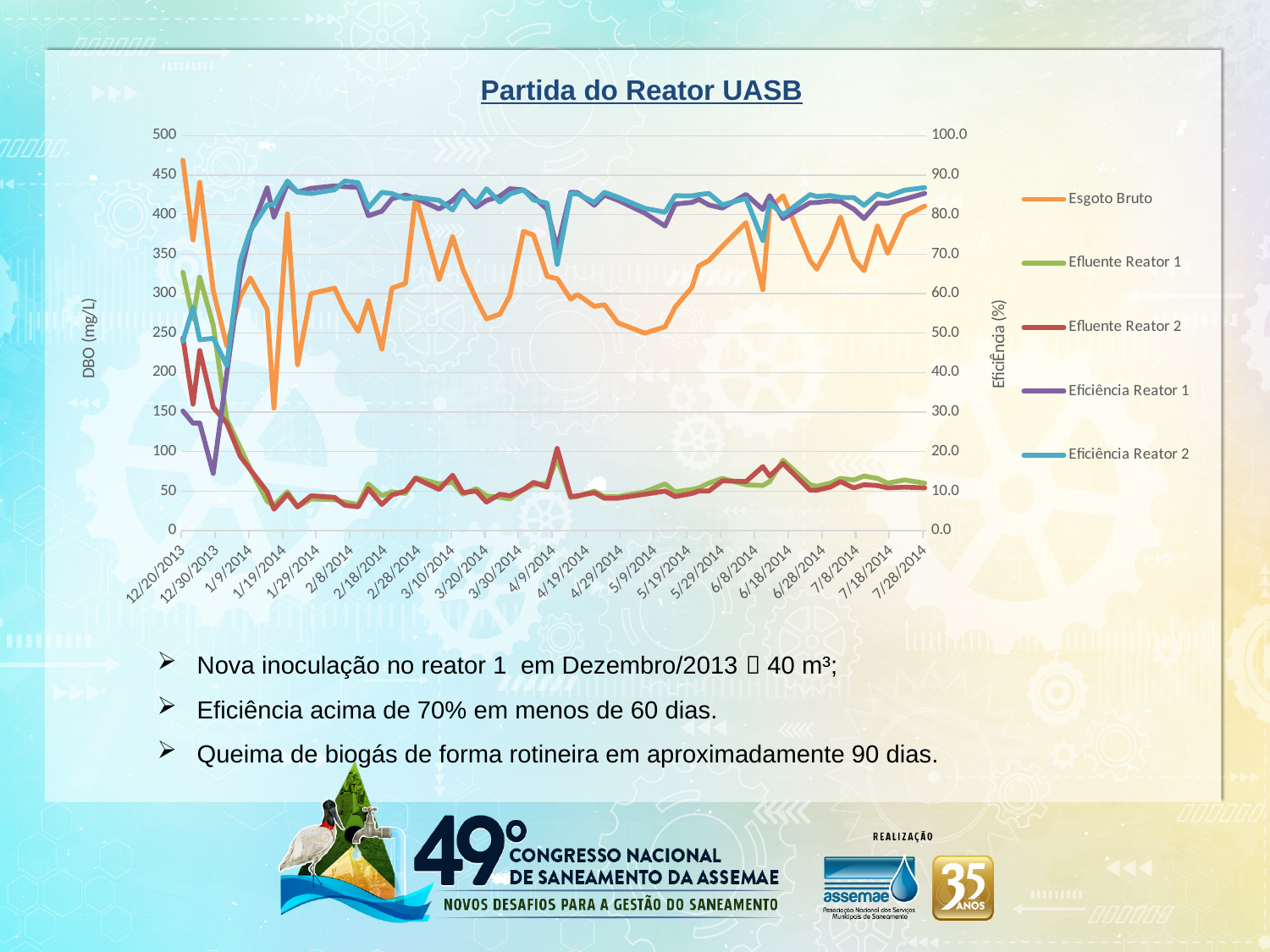
Is the value for Esgoto Bruto at 12/20/2013 greater or less than 400? greater What is the title of the chart? Partida do Reator UASB Does the Efluente Reator 1 series rise or fall overall from 12/20/2013 to 7/28/2014? fall What is the label of the left vertical axis? DBO (mg/L) Is the value for Eficiência Reator 1 at 12/20/2013 greater or less than 40.0? less At 7/28/2014, which is larger: Esgoto Bruto or Efluente Reator 1? Esgoto Bruto Is the value for Efluente Reator 2 at 12/20/2013 greater or less than 300? less How many series does the legend list? 5 What kind of chart is shown on the slide? line chart